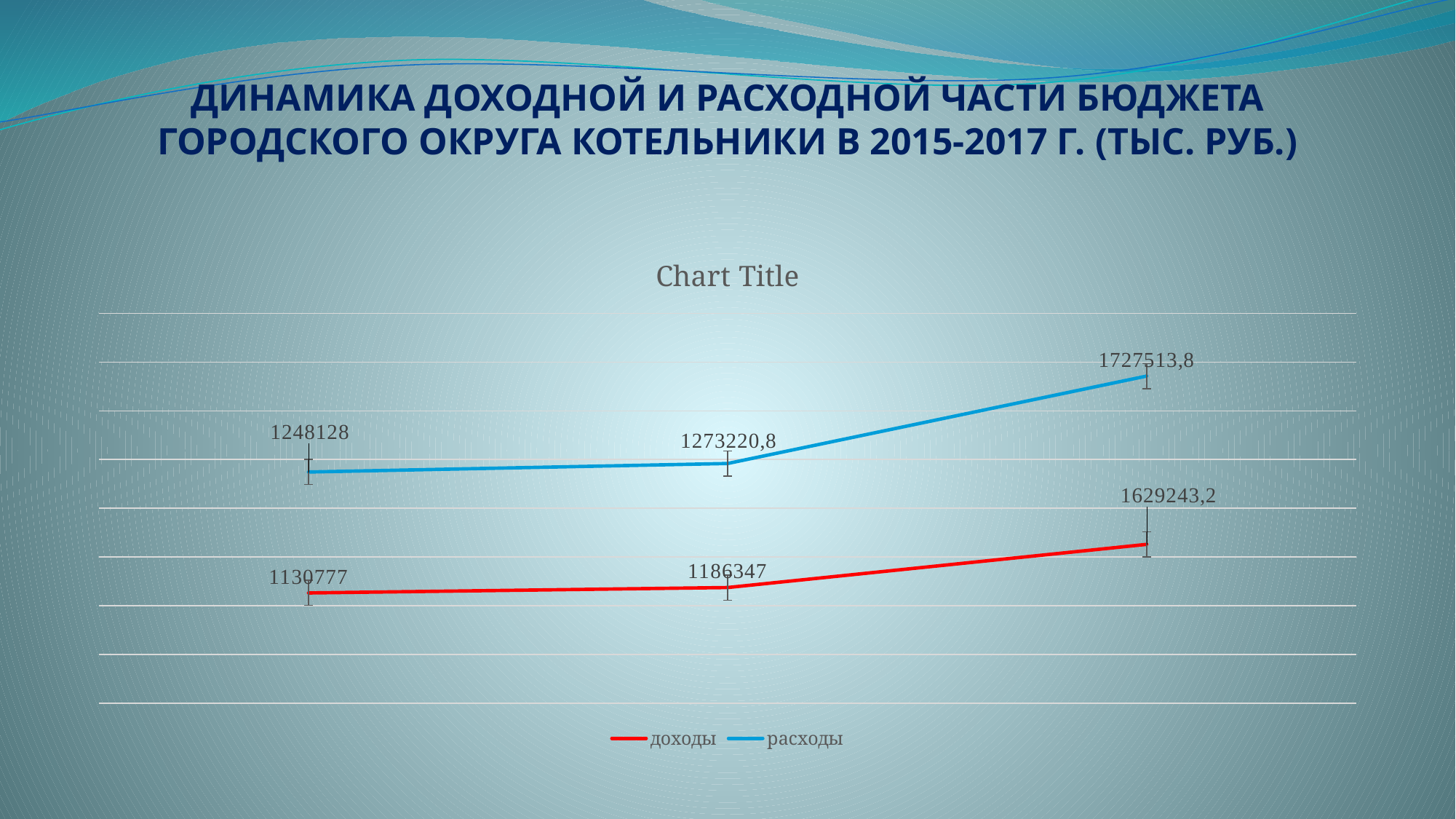
What kind of chart is shown on the slide? line chart What is the difference between расходы and доходы at the rightmost point? 98270,6 What is the value of the last (rightmost) point of the расходы series? 1727513,8 Do the values of the расходы series rise or fall from left to right? rise Which colour is used for the доходы line in the chart? red What is the value of the second (middle) point of the доходы series? 1186347 What is the value of the first (leftmost) point of the доходы series? 1130777 What is the value of the first (leftmost) point of the расходы series? 1248128 How many series does the chart legend list? 2 What is the value of the last (rightmost) point of the доходы series? 1629243,2 How many data points does each line in the chart have? 3 Which series has the higher value at the rightmost point, доходы or расходы? расходы